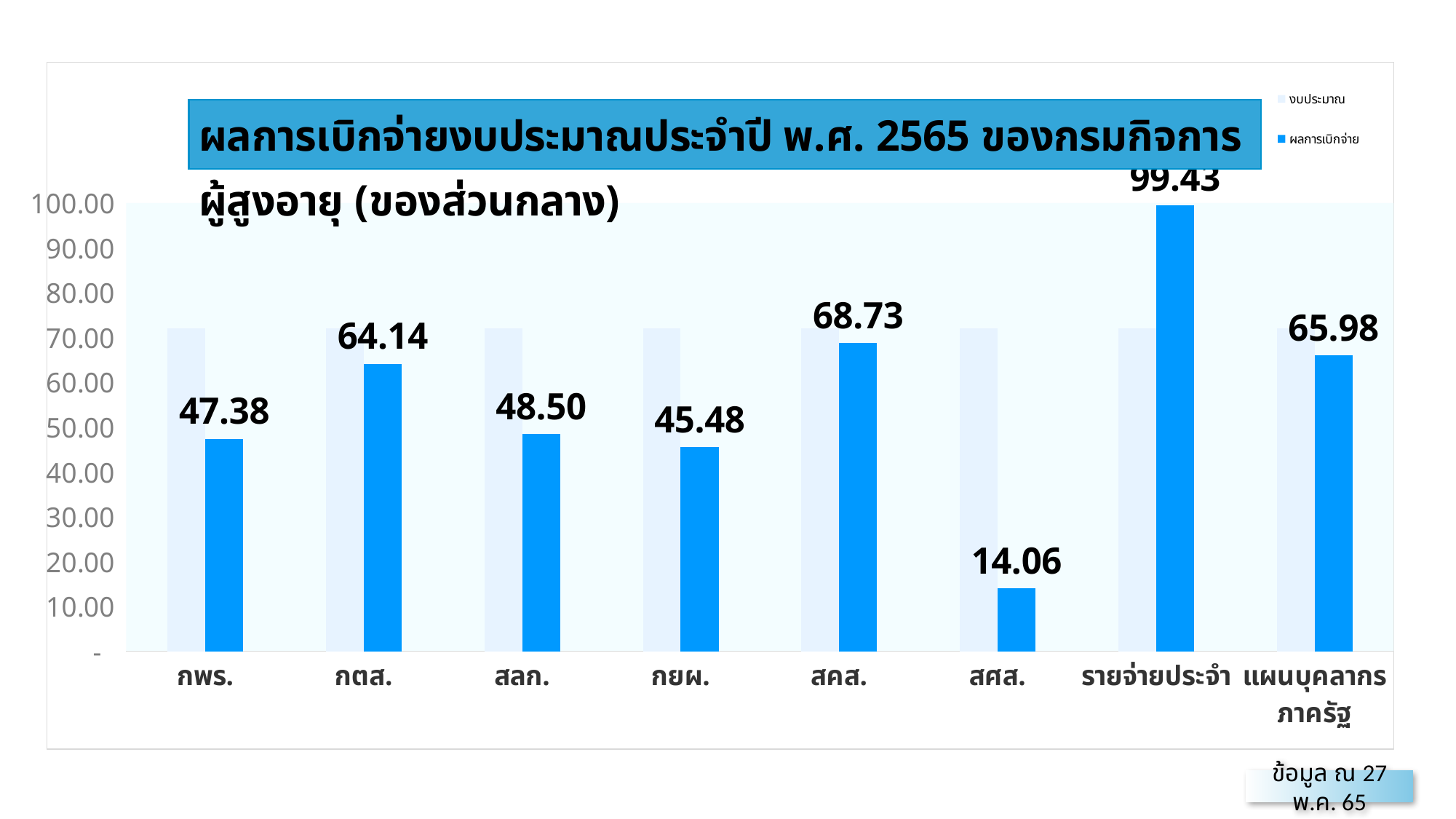
What is the difference between the ผลการเบิกจ่าย values for สคส. and กพร.? 21.35 Which category has the lowest ผลการเบิกจ่าย value? สศส. What is the ผลการเบิกจ่าย value for กตส.? 64.14 What are the two series named in the legend? งบประมาณ and ผลการเบิกจ่าย What is the ผลการเบิกจ่าย value for แผนบุคลากรภาครัฐ? 65.98 How many categories are shown on the x axis? 8 What kind of chart is shown on the slide? bar chart Which has a larger ผลการเบิกจ่าย value, กตส. or สลก.? กตส. How many series does the legend list? 2 Is the ผลการเบิกจ่าย value for กยผ. greater or less than 50.00? less Which category has the highest ผลการเบิกจ่าย value? รายจ่ายประจำ What is the ผลการเบิกจ่าย value for สศส.? 14.06